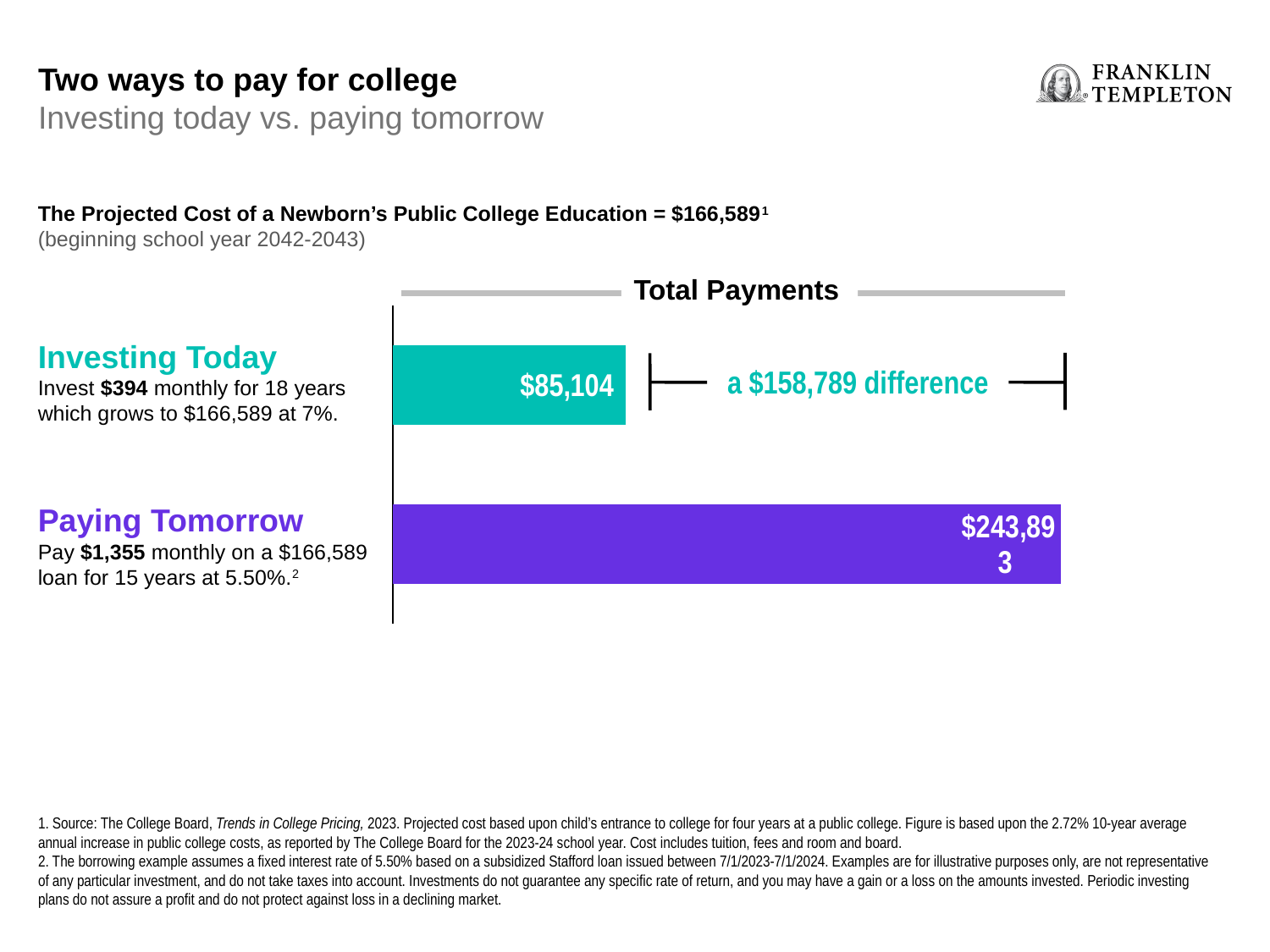
Is the total payment for Investing Today larger or smaller than the total payment for Paying Tomorrow? smaller What is the total payment value shown for Paying Tomorrow? $243,893 How many bars are plotted in the chart? 2 What is the title of the chart? Total Payments Which option has the higher total payments, Investing Today or Paying Tomorrow? Paying Tomorrow What colour is the bar for Paying Tomorrow? purple What is the total payment value shown for Investing Today? $85,104 What kind of chart is used to show the total payments? bar chart What is the difference in total payments between Paying Tomorrow and Investing Today? $158,789 Which option has the lower total payments? Investing Today